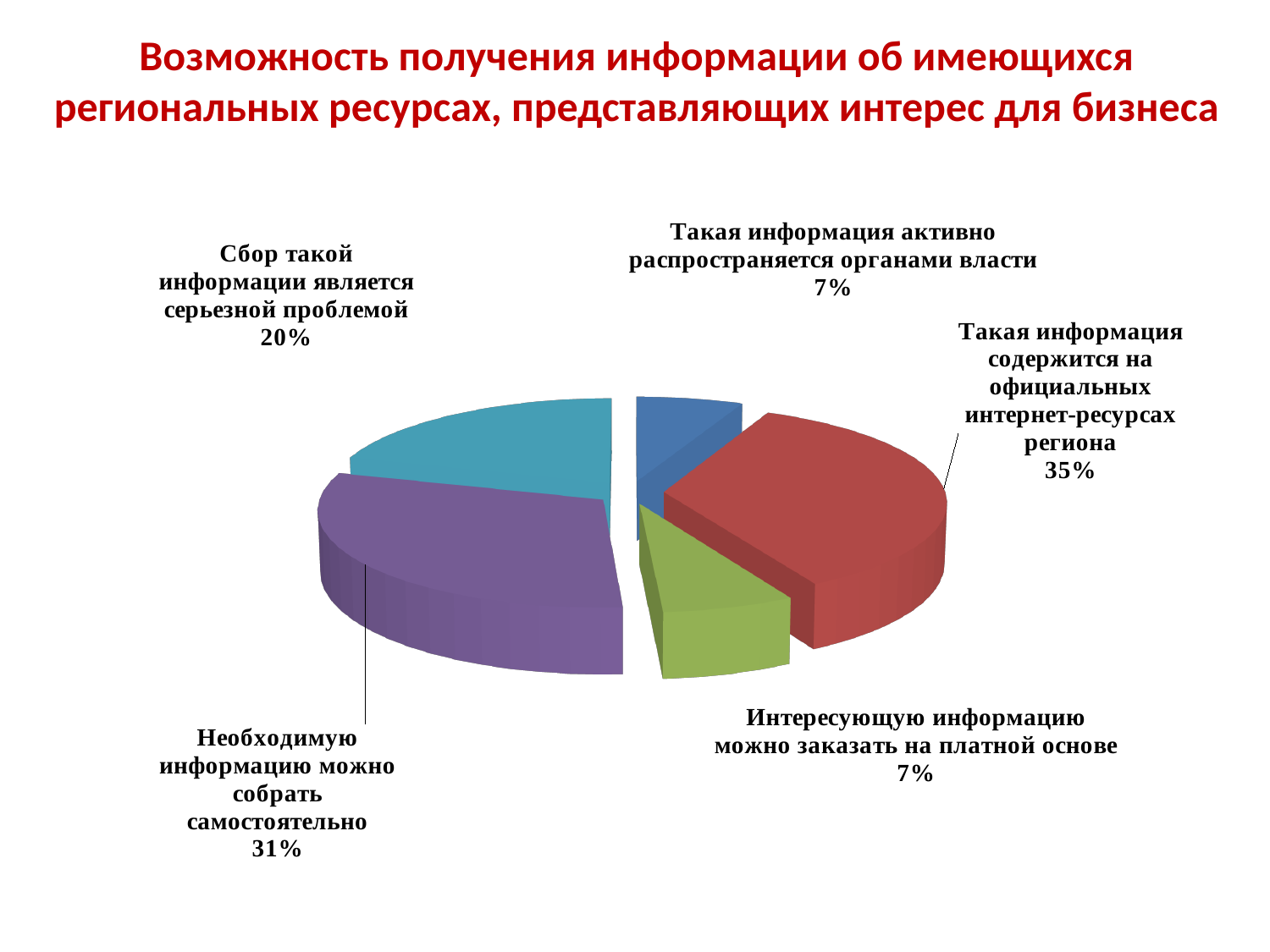
Which is larger: the share for 'Сбор такой информации является серьезной проблемой' or the share for 'Такая информация активно распространяется органами власти'? Сбор такой информации является серьезной проблемой Which category has the largest share of the pie? Такая информация содержится на официальных интернет-ресурсах региона What is the difference in percentage points between the share for 'Необходимую информацию можно собрать самостоятельно' and 'Сбор такой информации является серьезной проблемой'? 11 percentage points What share of respondents said such information is actively distributed by authorities (Такая информация активно распространяется органами власти)? 7% What type of chart is shown on the slide? Pie chart What share of respondents said the information of interest can be ordered on a paid basis (Интересующую информацию можно заказать на платной основе)? 7% How many slices does the pie chart have? 5 What colour is the slice for 'Такая информация содержится на официальных интернет-ресурсах региона'? Red What share of respondents said collecting such information is a serious problem (Сбор такой информации является серьезной проблемой)? 20% What share of respondents said the necessary information can be collected independently (Необходимую информацию можно собрать самостоятельно)? 31% What share of respondents said such information is contained on official internet resources of the region (Такая информация содержится на официальных интернет-ресурсах региона)? 35% What is the difference in percentage points between the share for 'Такая информация содержится на официальных интернет-ресурсах региона' and 'Необходимую информацию можно собрать самостоятельно'? 4 percentage points